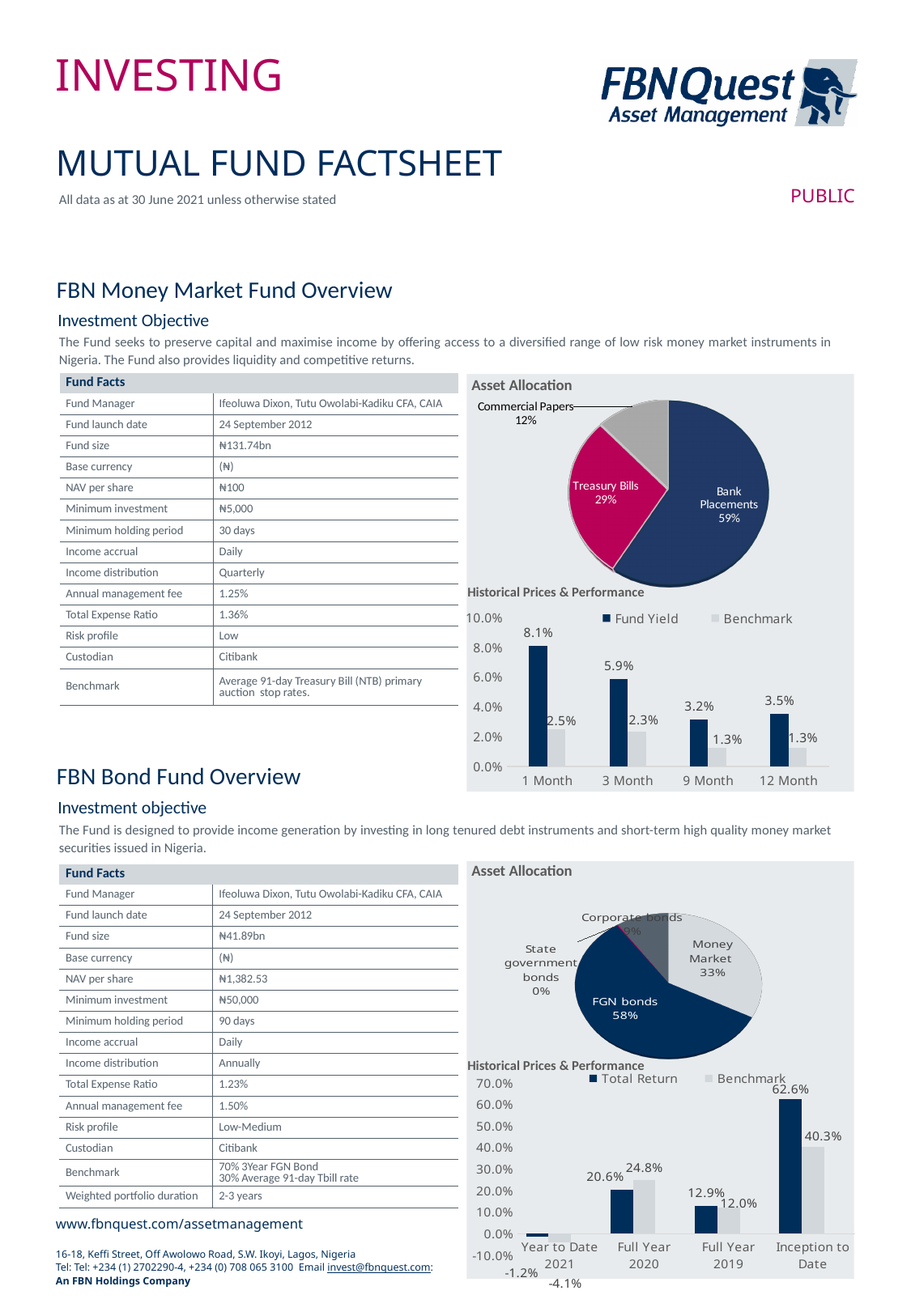
How many slices does the FBN Money Market Fund asset allocation pie chart have? 3 In the FBN Money Market Fund asset allocation pie chart, which category has the smallest share? Commercial Papers In the FBN Bond Fund asset allocation pie chart, which category has the largest share? FGN bonds What type of chart is the FBN Money Market Fund Historical Prices & Performance chart? Bar chart In the FBN Bond Fund Historical Prices & Performance chart, what is the Total Return for Inception to Date? 62.6% In the FBN Bond Fund Historical Prices & Performance chart, which is larger for Full Year 2020, Total Return or Benchmark? Benchmark In the FBN Money Market Fund Historical Prices & Performance chart, what is the Fund Yield for 1 Month? 8.1% In the FBN Money Market Fund Historical Prices & Performance chart, what is the difference between the Fund Yield and the Benchmark for 12 Month? 2.2% In the FBN Money Market Fund Historical Prices & Performance chart, what is the Benchmark value for 3 Month? 2.3% In the FBN Money Market Fund asset allocation pie chart, what share is Bank Placements? 59% In the FBN Bond Fund asset allocation pie chart, what share is FGN bonds? 58% How many series does the legend of the FBN Money Market Fund Historical Prices & Performance chart list? 2